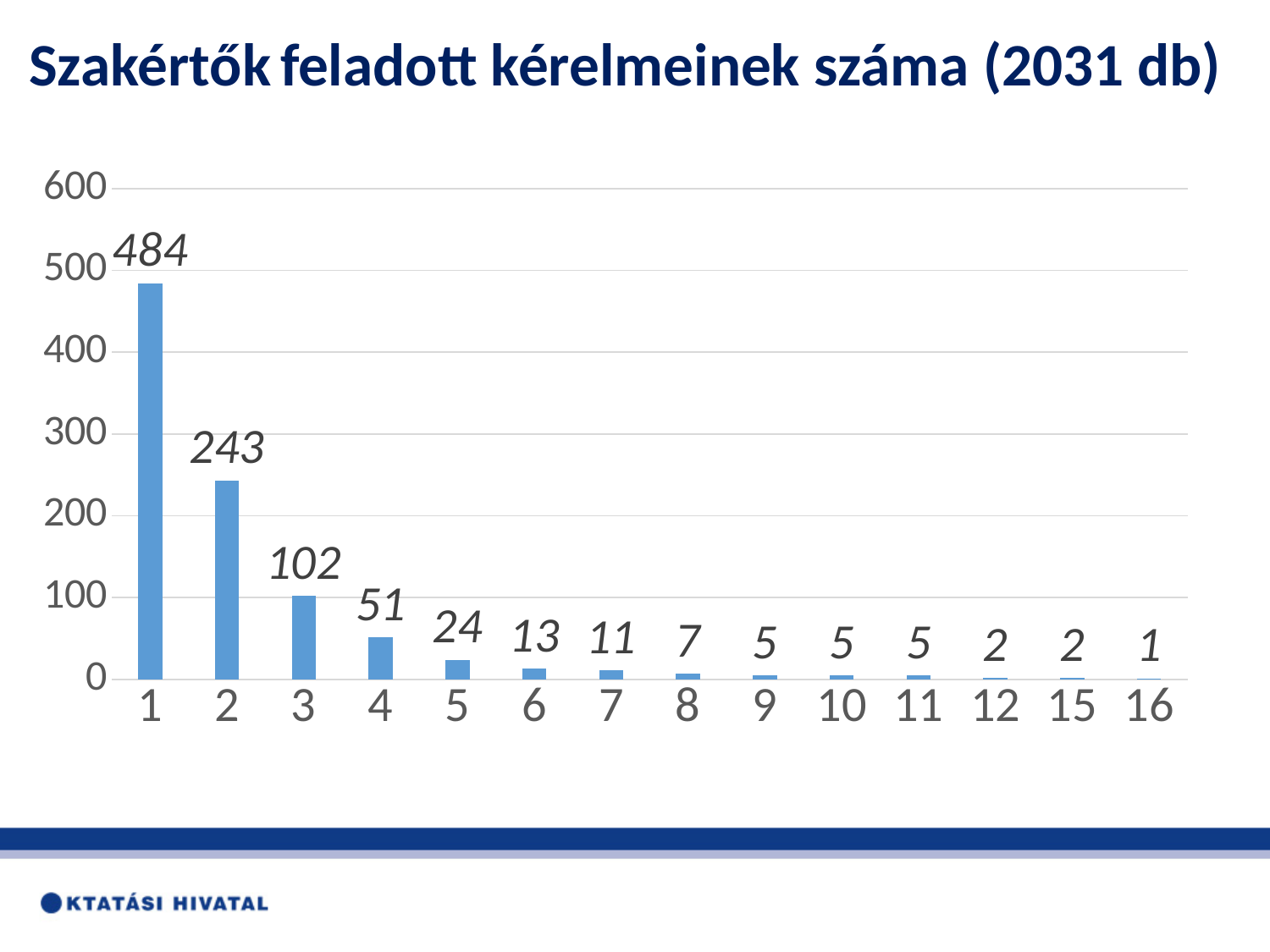
Which is larger, the value for category 4 or the value for category 6? category 4 What kind of chart is shown on the slide? bar chart How many categories are shown on the x axis? 14 What is the value for category 16? 1 Do the values rise or fall from left to right along the x axis? fall Which category has the lowest value? 16 Is the value for category 2 greater or less than 200? greater What is the value for category 1? 484 What is the value for category 3? 102 What is the difference between the values for category 1 and category 2? 241 Which category has the highest value? 1 What is the value for category 5? 24